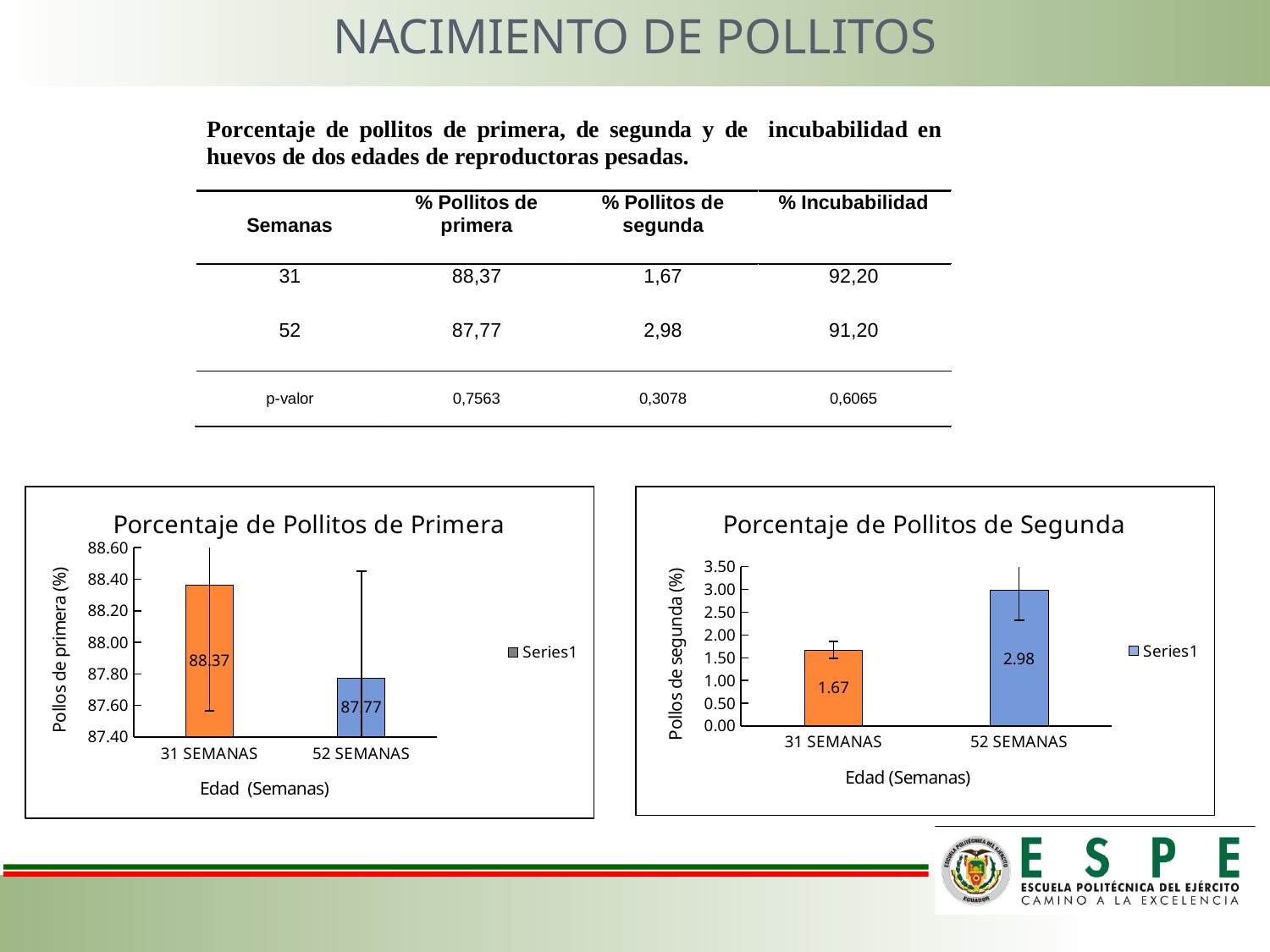
In the 'Porcentaje de Pollitos de Primera' chart, what is the value for 31 SEMANAS? 88.37 What is the y-axis label of the 'Porcentaje de Pollitos de Segunda' chart? Pollos de segunda (%) In the 'Porcentaje de Pollitos de Primera' chart, what is the difference between the values for 31 SEMANAS and 52 SEMANAS? 0.60 In the 'Porcentaje de Pollitos de Segunda' chart, which category has the lowest value? 31 SEMANAS How many categories are shown in the 'Porcentaje de Pollitos de Primera' chart? 2 In the 'Porcentaje de Pollitos de Segunda' chart, is the value for 52 SEMANAS greater or less than 2.50? greater In the 'Porcentaje de Pollitos de Primera' chart, what is the value for 52 SEMANAS? 87.77 In the 'Porcentaje de Pollitos de Primera' chart, which category has the highest value? 31 SEMANAS In the 'Porcentaje de Pollitos de Segunda' chart, what is the value for 31 SEMANAS? 1.67 In the 'Porcentaje de Pollitos de Segunda' chart, what is the value for 52 SEMANAS? 2.98 In the 'Porcentaje de Pollitos de Segunda' chart, what is the difference between the values for 52 SEMANAS and 31 SEMANAS? 1.31 What kind of chart is the 'Porcentaje de Pollitos de Segunda' chart? bar chart